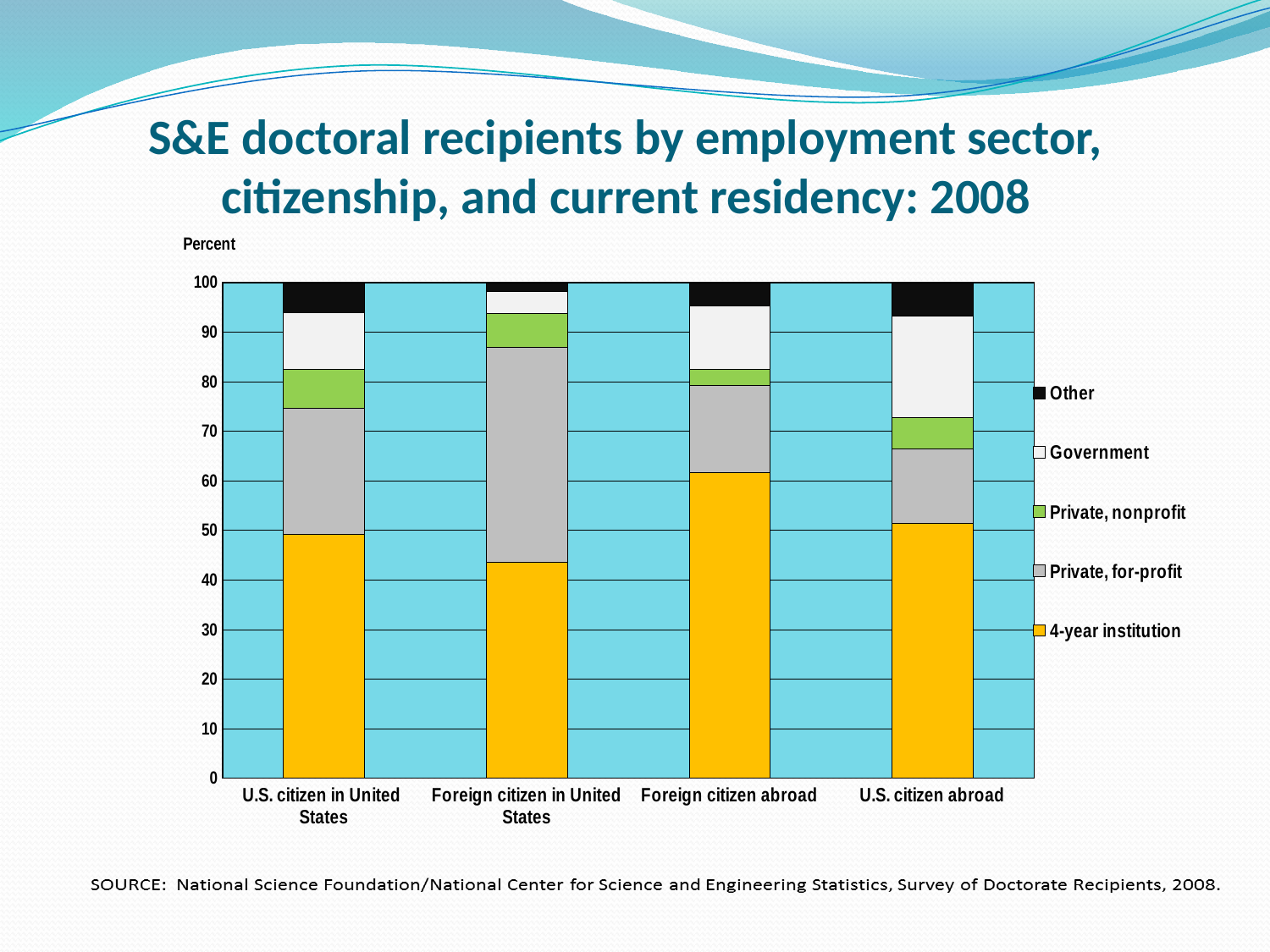
Which category has the smallest 4-year institution segment? Foreign citizen in United States Which is larger, the 4-year institution segment for Foreign citizen abroad or for Foreign citizen in United States? Foreign citizen abroad Which category has the largest Private, for-profit segment? Foreign citizen in United States What is the total height of each stacked bar on the y axis? 100 What kind of chart is shown on the slide? Stacked bar chart How many categories are shown along the x axis? 4 Which category has the largest 4-year institution segment? Foreign citizen abroad What label is shown on the y axis? Percent Is the 4-year institution value for Foreign citizen abroad greater or less than 50? greater Which category has the largest Government segment? U.S. citizen abroad How many series does the legend list? 5 Is the 4-year institution value for Foreign citizen in United States greater or less than 50? less